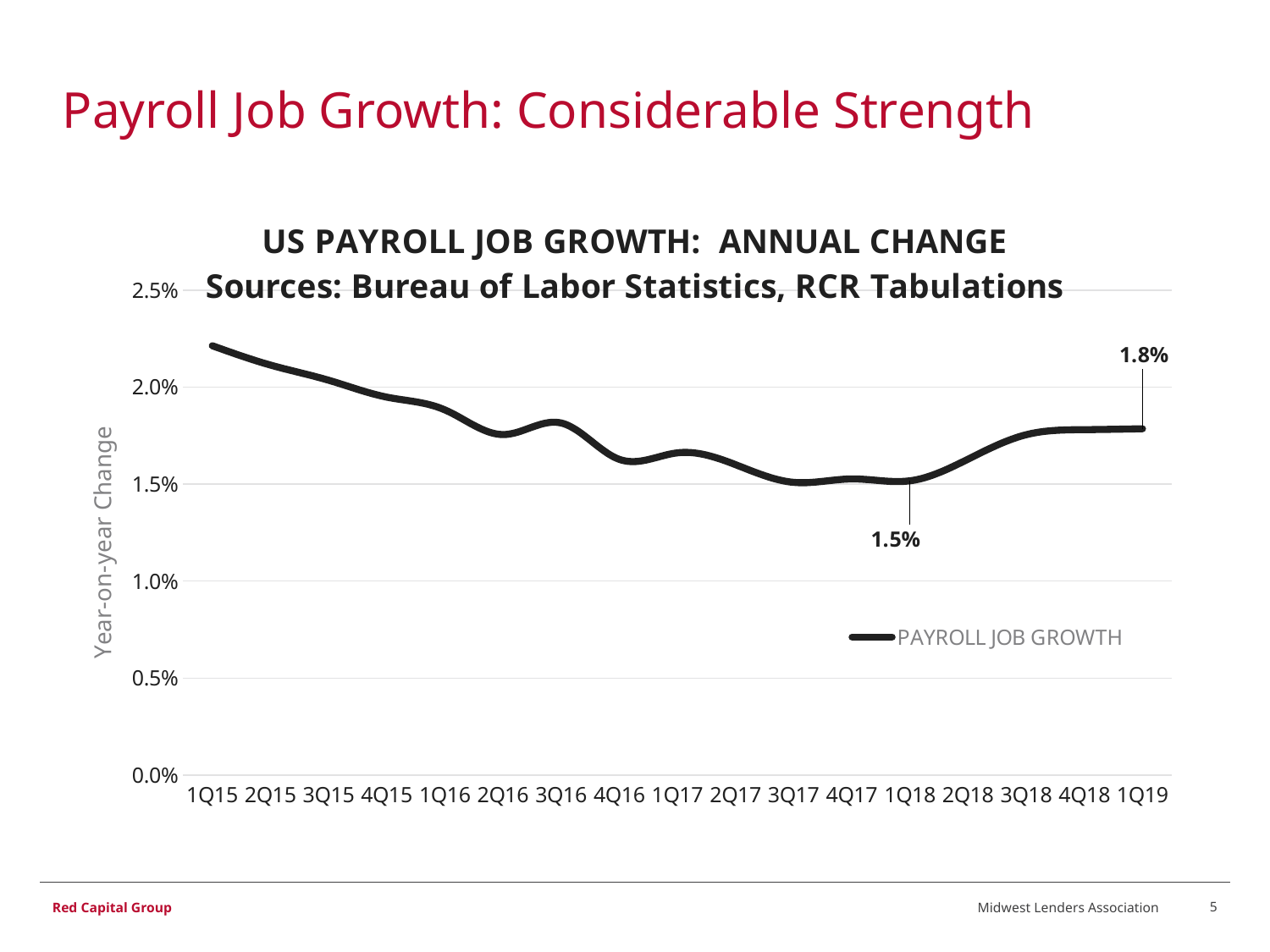
What is the difference between the labelled values for 1Q19 and 1Q18? 0.3% What is the value for 1Q18 on the US Payroll Job Growth chart? 1.5% Is the value for 3Q17 greater or less than 1.0%? greater Which is larger, the value for 1Q15 or the value for 1Q19? 1Q15 What kind of chart is shown on the slide? line chart What is the value for 1Q19 on the US Payroll Job Growth chart? 1.8% How many quarters are plotted on the x axis of the chart? 17 Is the value for 4Q16 greater or less than 2.0%? less Is the value for 1Q15 greater or less than 2.0%? greater Does payroll job growth rise or fall from 1Q15 to 1Q18? fall Which quarter has the highest payroll job growth on the chart? 1Q15 How many series does the legend list? 1